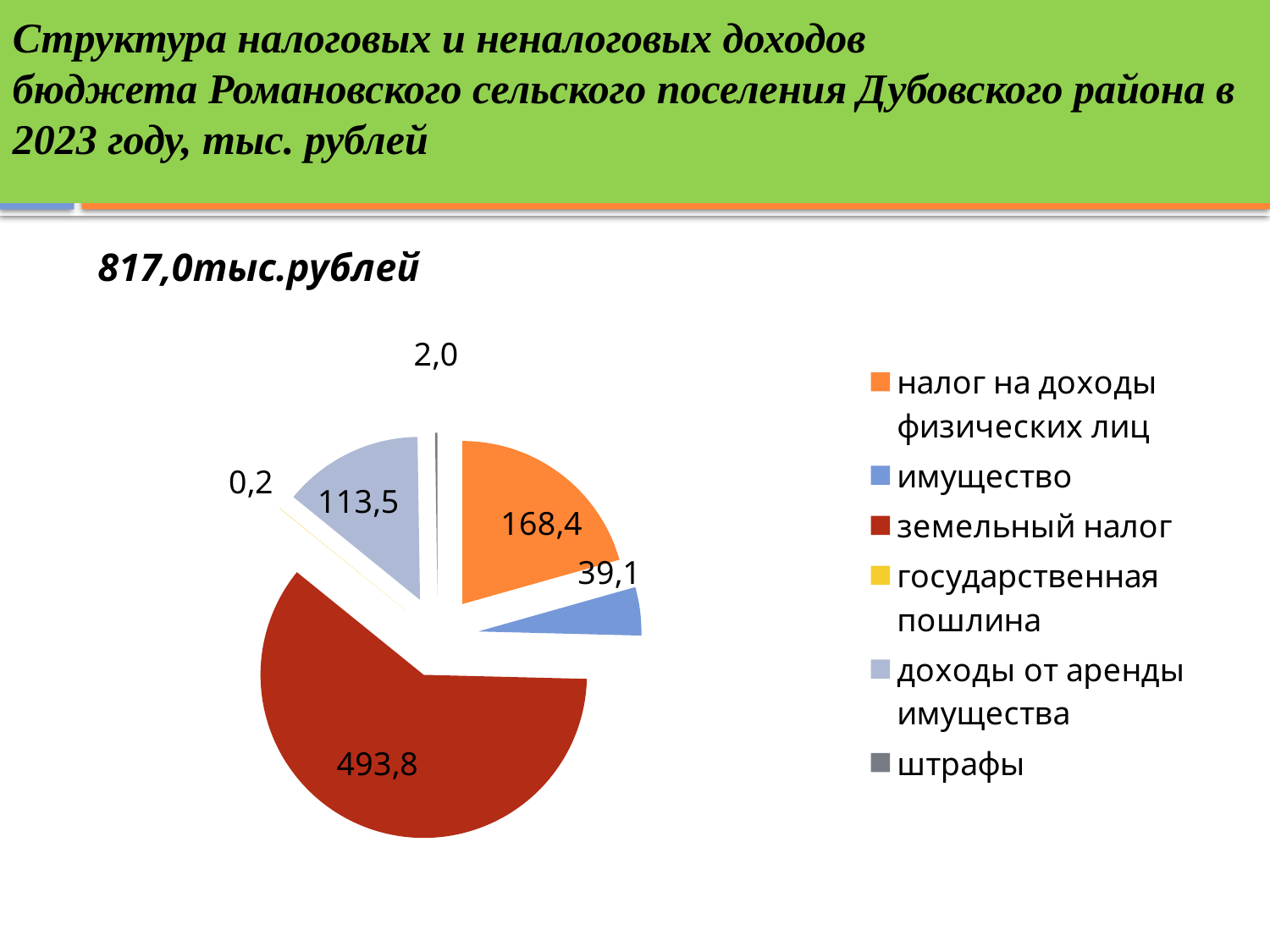
What is the value for доходы от аренды имущества? 113,5 What total amount in thousand rubles is stated above the pie chart? 817,0тыс.рублей Which is larger: налог на доходы физических лиц or доходы от аренды имущества? налог на доходы физических лиц How many categories does the legend list? 6 What is the difference between the values for земельный налог and налог на доходы физических лиц? 325,4 What is the value for налог на доходы физических лиц? 168,4 What type of chart is shown on the slide? pie chart What is the value for имущество? 39,1 Which category has the smallest slice of the pie? государственная пошлина What is the value for штрафы? 2,0 What is the value for земельный налог? 493,8 Which category has the largest slice of the pie? земельный налог